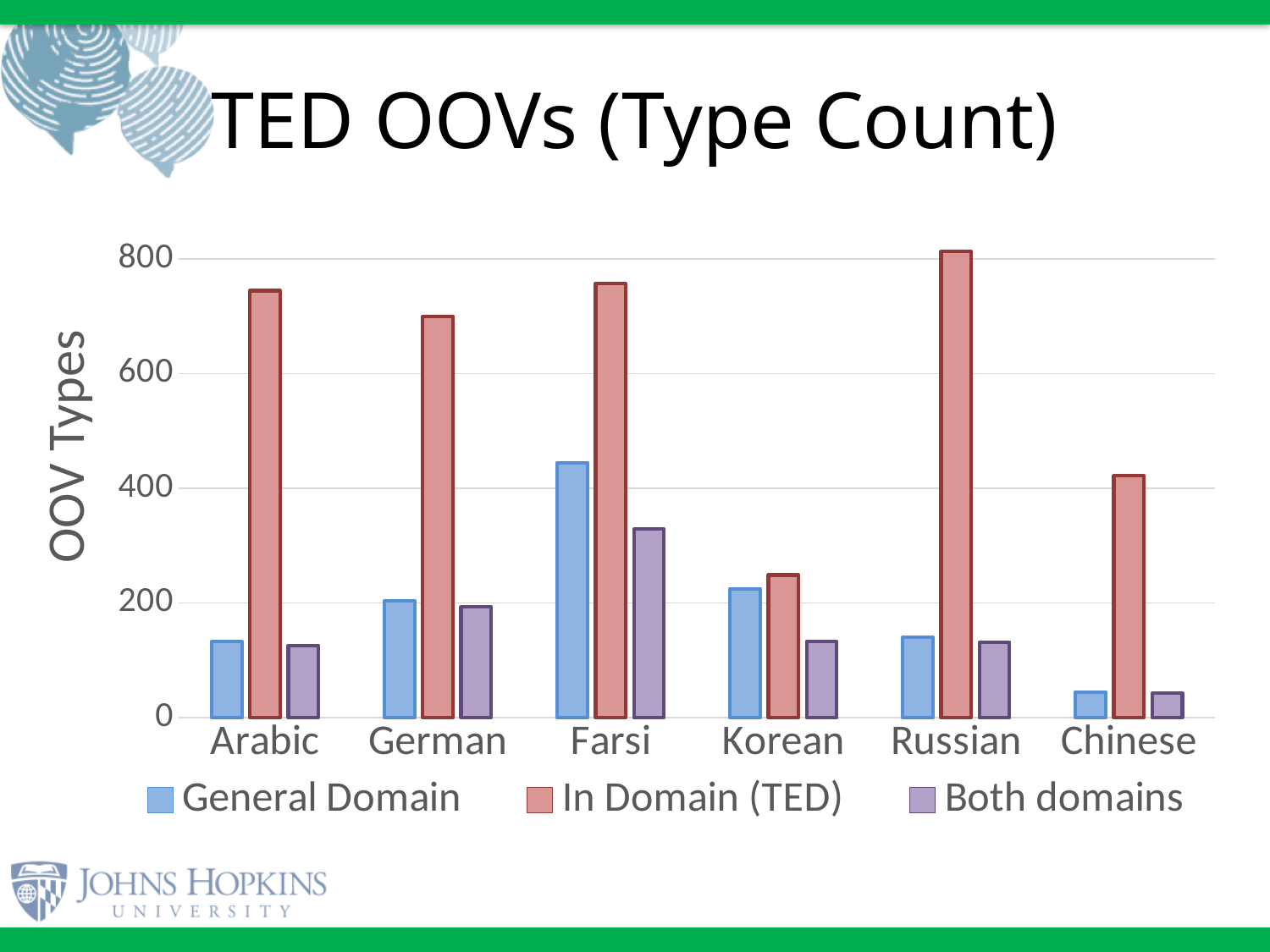
Which language has the lowest Both domains value? Chinese How many series does the legend list? 3 Is the In Domain (TED) value for Arabic greater or less than 800? less What kind of chart is shown on the slide? bar chart How many languages are shown on the x axis? 6 Which language has the lowest In Domain (TED) value? Korean Which is larger, the Both domains value for Farsi or for German? Farsi Which language has the highest General Domain value? Farsi Which language has the highest In Domain (TED) value? Russian Is the General Domain value for Farsi greater or less than 400? greater What is the label of the y axis? OOV Types Is the In Domain (TED) value for Chinese greater or less than 600? less